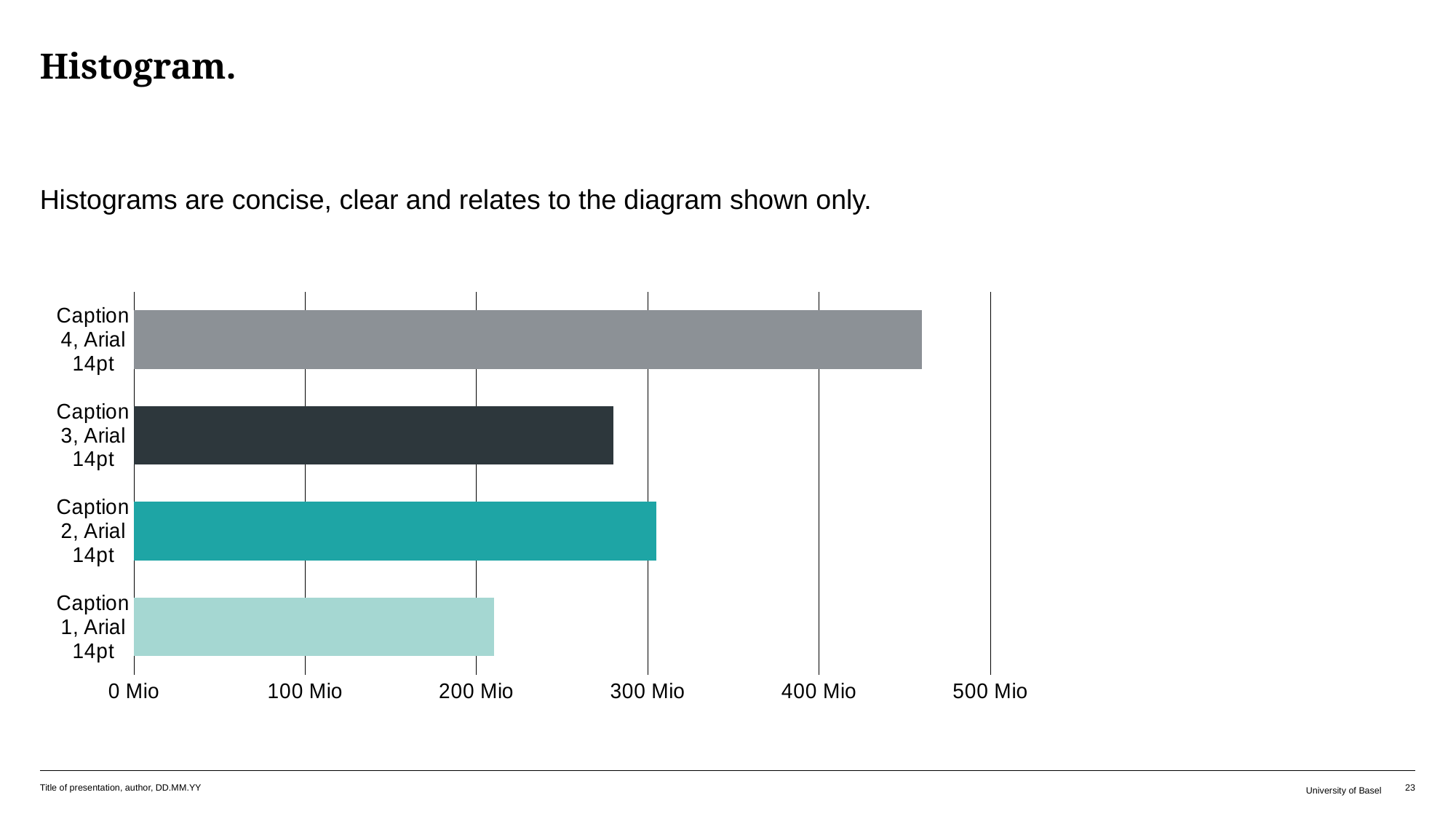
Which has the larger value, Caption 2, Arial 14pt or Caption 3, Arial 14pt? Caption 2, Arial 14pt How many categories (bars) does the chart show? 4 Which category has the lowest value? Caption 1, Arial 14pt Is the value for Caption 1, Arial 14pt greater or less than 300 Mio? less Which has the larger value, Caption 1, Arial 14pt or Caption 4, Arial 14pt? Caption 4, Arial 14pt Which category has the highest value? Caption 4, Arial 14pt What is the title of the slide containing the chart? Histogram. Is the value for Caption 4, Arial 14pt greater or less than 400 Mio? greater What kind of chart is shown on the slide? bar chart Is the value for Caption 2, Arial 14pt greater or less than 200 Mio? greater